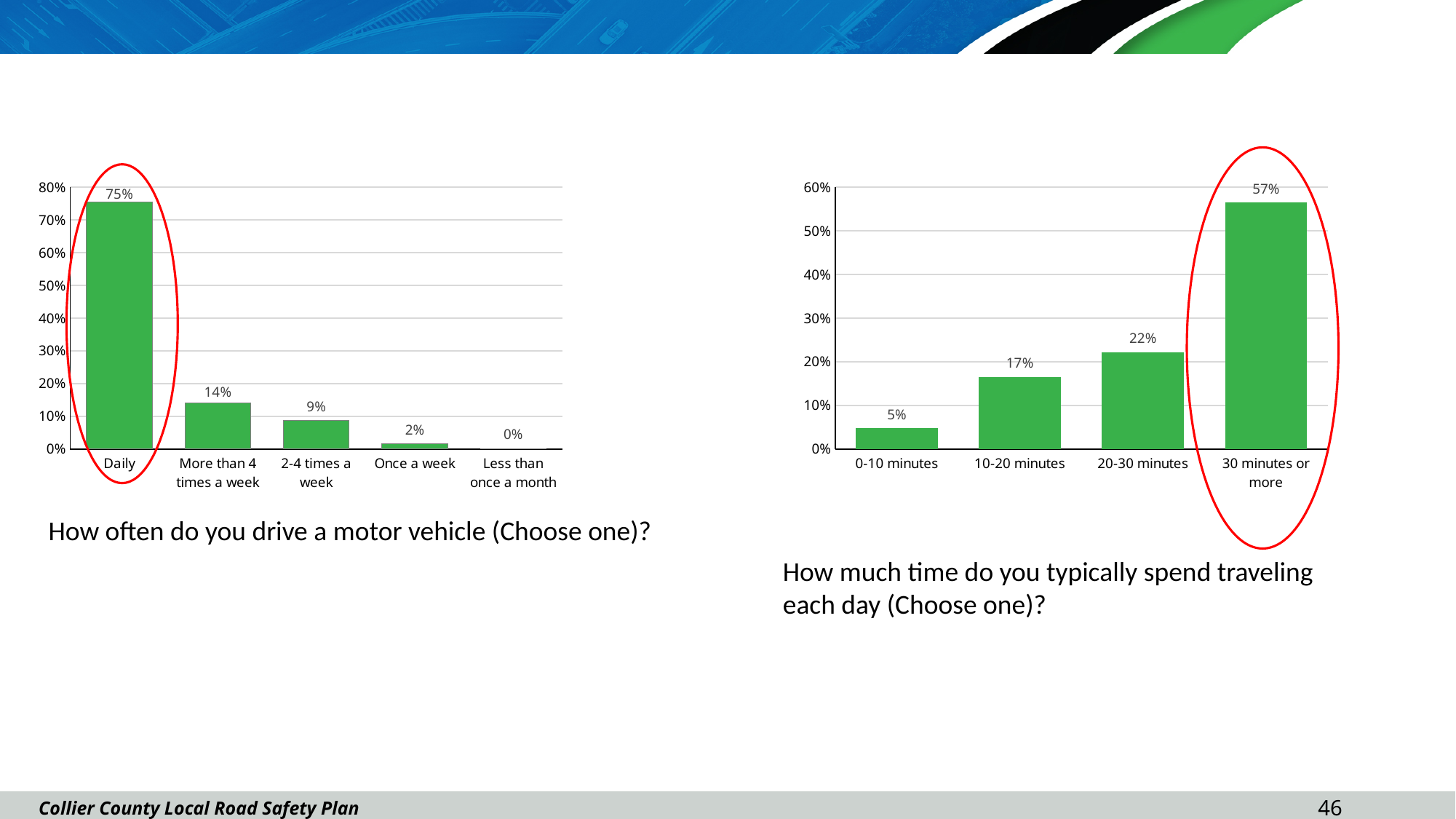
In the left chart (How often do you drive a motor vehicle), what percentage of respondents answered Daily? 75% In the left chart (How often do you drive a motor vehicle), what is the difference between the Daily value and the More than 4 times a week value? 61% What kind of chart is the right chart (How much time do you typically spend traveling each day)? bar chart In the right chart (How much time do you typically spend traveling each day), what is the difference between the 30 minutes or more value and the 20-30 minutes value? 35% In the right chart (How much time do you typically spend traveling each day), which is larger: the value for 20-30 minutes or the value for 0-10 minutes? 20-30 minutes In the right chart (How much time do you typically spend traveling each day), what is the value for 10-20 minutes? 17% In the left chart (How often do you drive a motor vehicle), do the values rise or fall from left to right along the x axis? fall In the left chart (How often do you drive a motor vehicle), how many categories are shown on the x axis? 5 In the left chart (How often do you drive a motor vehicle), what is the value for 2-4 times a week? 9% In the right chart (How much time do you typically spend traveling each day), which category has the highest value? 30 minutes or more In the right chart (How much time do you typically spend traveling each day), what is the value for 30 minutes or more? 57% In the left chart (How often do you drive a motor vehicle), which category has the lowest value? Less than once a month